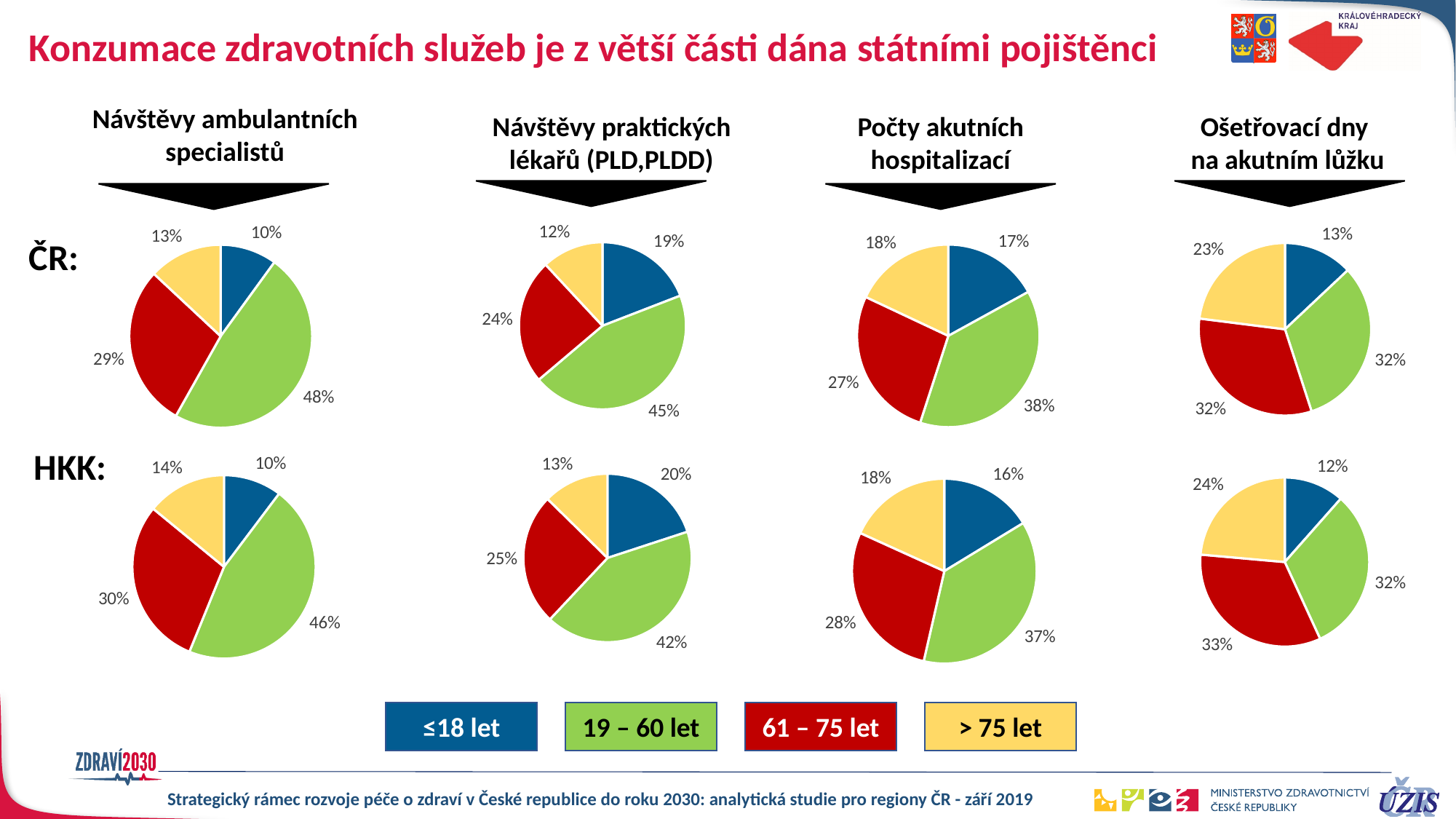
In the ČR pie chart for Návštěvy praktických lékařů (PLD,PLDD), which age group has the smallest slice? > 75 let How many slices does each pie chart on the slide have? 4 In the ČR pie chart for Návštěvy ambulantních specialistů, what share is the 19 – 60 let slice? 48% In the ČR pie chart for Počty akutních hospitalizací, what share is the 61 – 75 let slice? 27% In the HKK pie chart for Počty akutních hospitalizací, what is the difference between the 19 – 60 let share and the 61 – 75 let share? 9% Which colour represents the 61 – 75 let age group in the legend? Red In the ČR pie chart for Ošetřovací dny na akutním lůžku, which is larger: the > 75 let slice or the ≤18 let slice? > 75 let In the HKK pie chart for Ošetřovací dny na akutním lůžku, what share is the > 75 let slice? 24% In the HKK pie chart for Návštěvy ambulantních specialistů, which age group has the largest slice? 19 – 60 let What type of chart is used for the ČR Počty akutních hospitalizací data? Pie chart How many age groups does the legend at the bottom of the slide list? 4 In the HKK pie chart for Návštěvy praktických lékařů (PLD,PLDD), what share is the ≤18 let slice? 20%